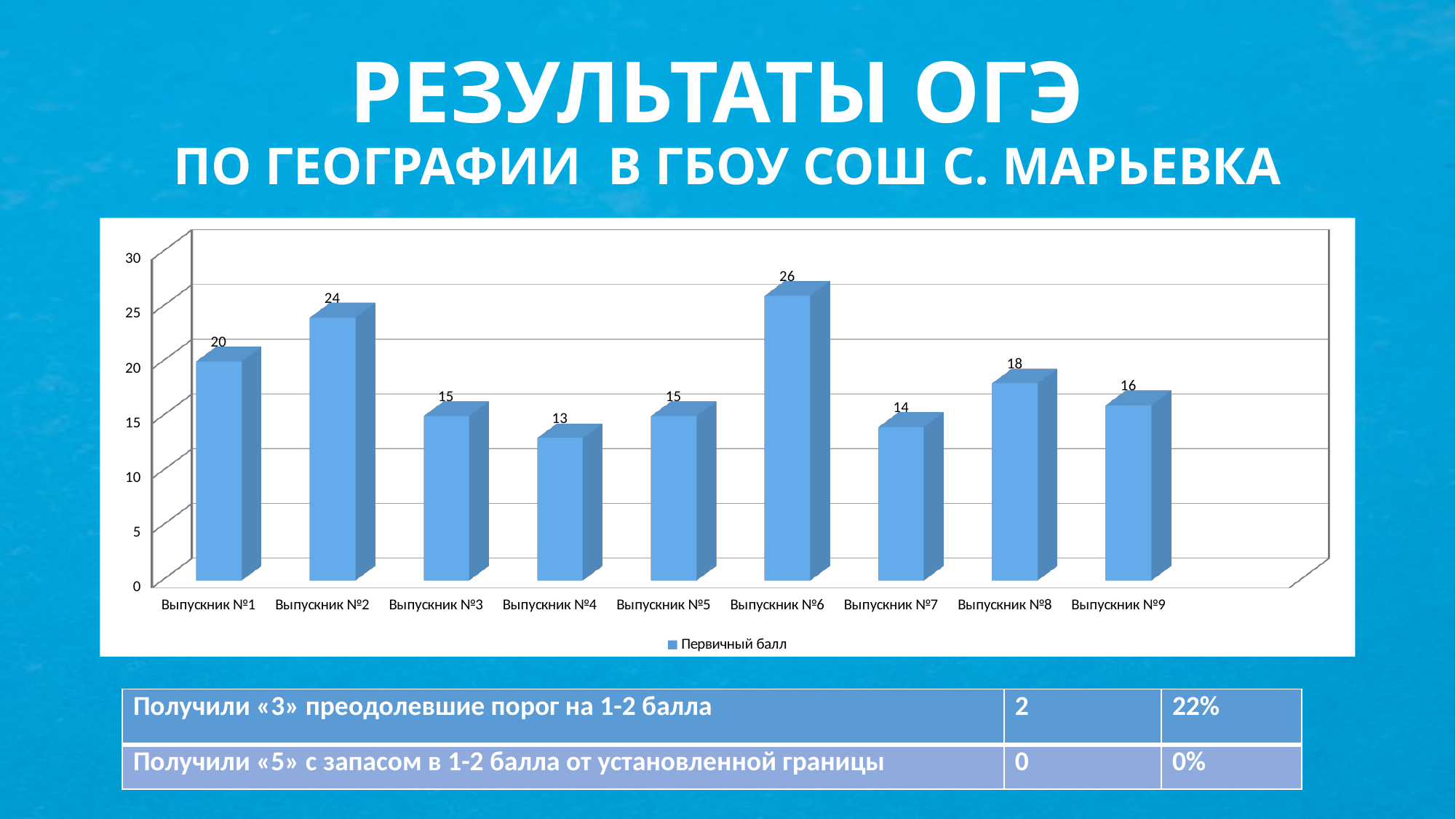
How many series does the legend list? 1 Which category has the highest value? Выпускник №6 What is the difference between the values for Выпускник №2 and Выпускник №1? 4 How many categories are shown on the x axis? 9 What is the value for Выпускник №4? 13 What is the value for Выпускник №6? 26 Which category has the lowest value? Выпускник №4 What is the value for Выпускник №8? 18 What is the legend entry for the series shown? Первичный балл What kind of chart is shown on the slide? bar chart Is the value for Выпускник №2 greater or less than 20? greater Which is larger, the value for Выпускник №9 or the value for Выпускник №7? Выпускник №9